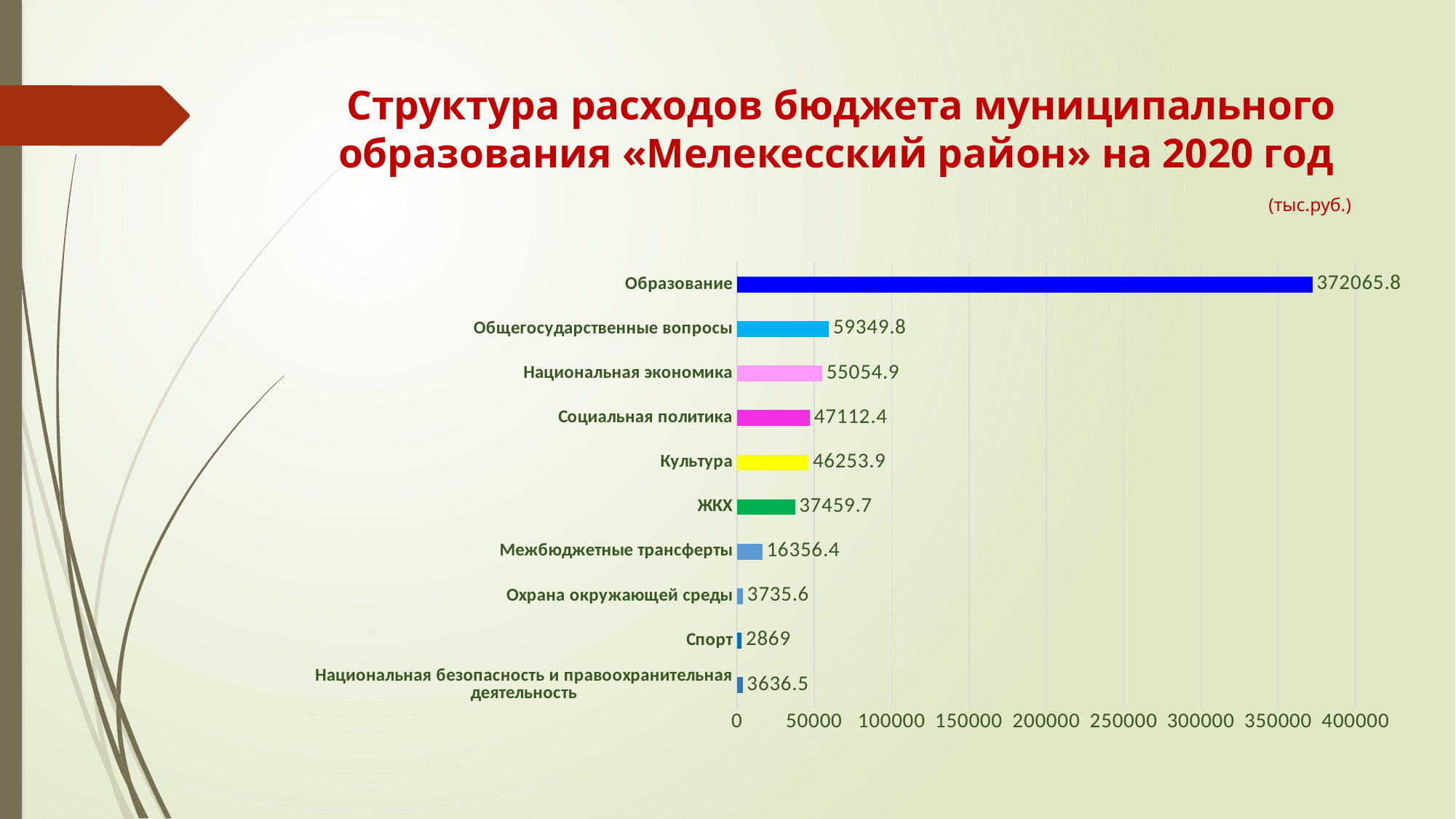
Which is larger: the value for Охрана окружающей среды or the value for Национальная безопасность и правоохранительная деятельность? Охрана окружающей среды What unit is indicated for the values in the chart? тыс.руб. What is the difference between the values for Социальная политика and Культура? 858.5 Which category has the highest value? Образование What is the value for Образование? 372065.8 What is the value for Спорт? 2869 What is the difference between the values for Общегосударственные вопросы and Национальная экономика? 4294.9 How many categories are plotted in the chart? 10 Is the value for ЖКХ greater or less than 50000? less What type of chart is shown on the slide? bar chart What is the value for Межбюджетные трансферты? 16356.4 Which category has the lowest value? Спорт